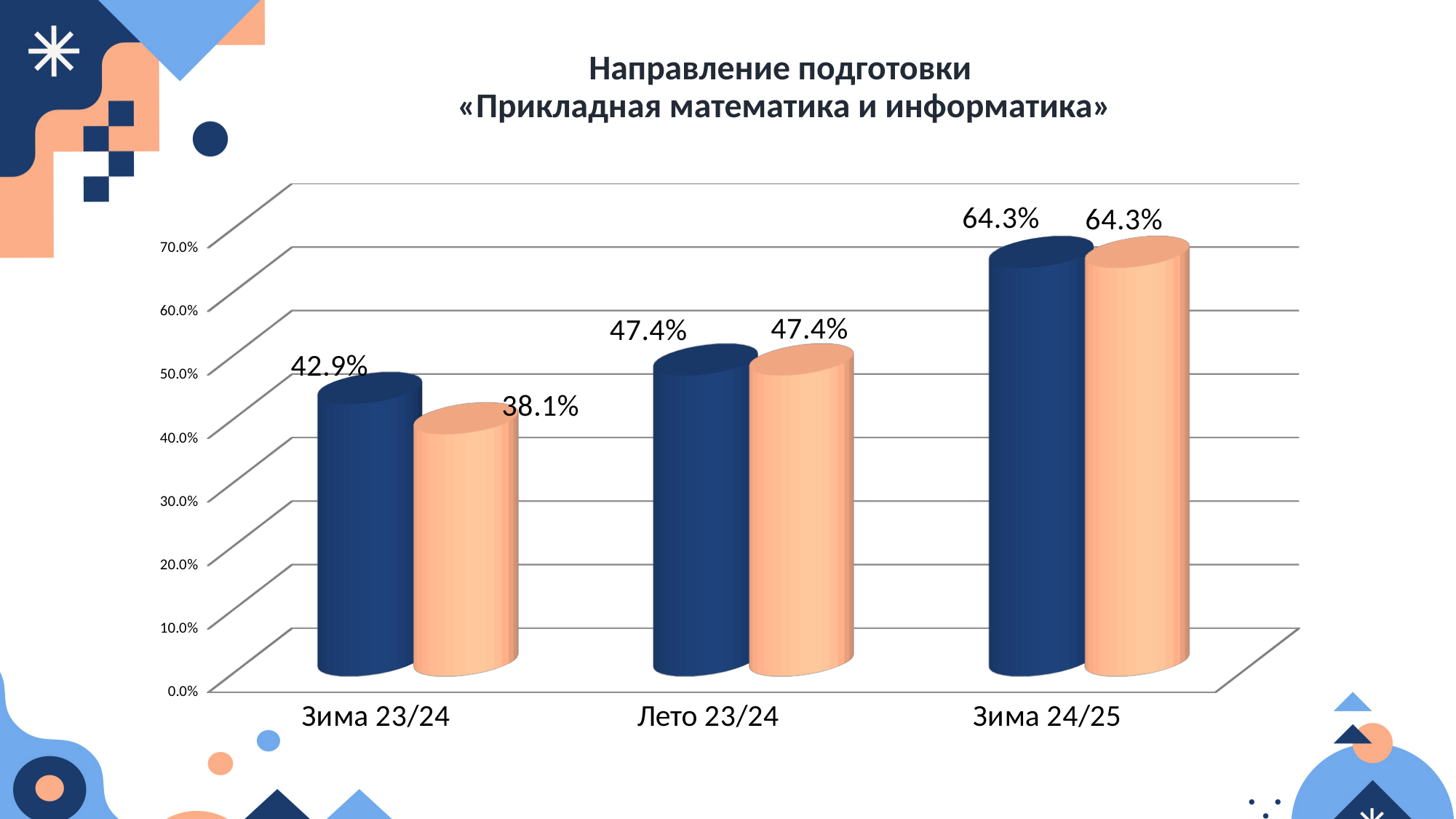
Which category has the highest value for the dark blue bars? Зима 24/25 Do the dark blue bar values rise or fall from Зима 23/24 to Зима 24/25? rise What is the value of the dark blue bar for Зима 23/24? 42.9% Which category has the lowest value for the orange bars? Зима 23/24 What is the difference between the dark blue and orange bars for Зима 23/24? 4.8% Which is larger for Зима 23/24: the dark blue bar or the orange bar? the dark blue bar What is the difference between the dark blue bar for Зима 24/25 and the dark blue bar for Лето 23/24? 16.9% What kind of chart is shown on the slide? bar chart What is the value of the orange bar for Зима 24/25? 64.3% What is the value of the orange bar for Зима 23/24? 38.1% How many categories are shown on the x axis? 3 What is the value of the dark blue bar for Лето 23/24? 47.4%